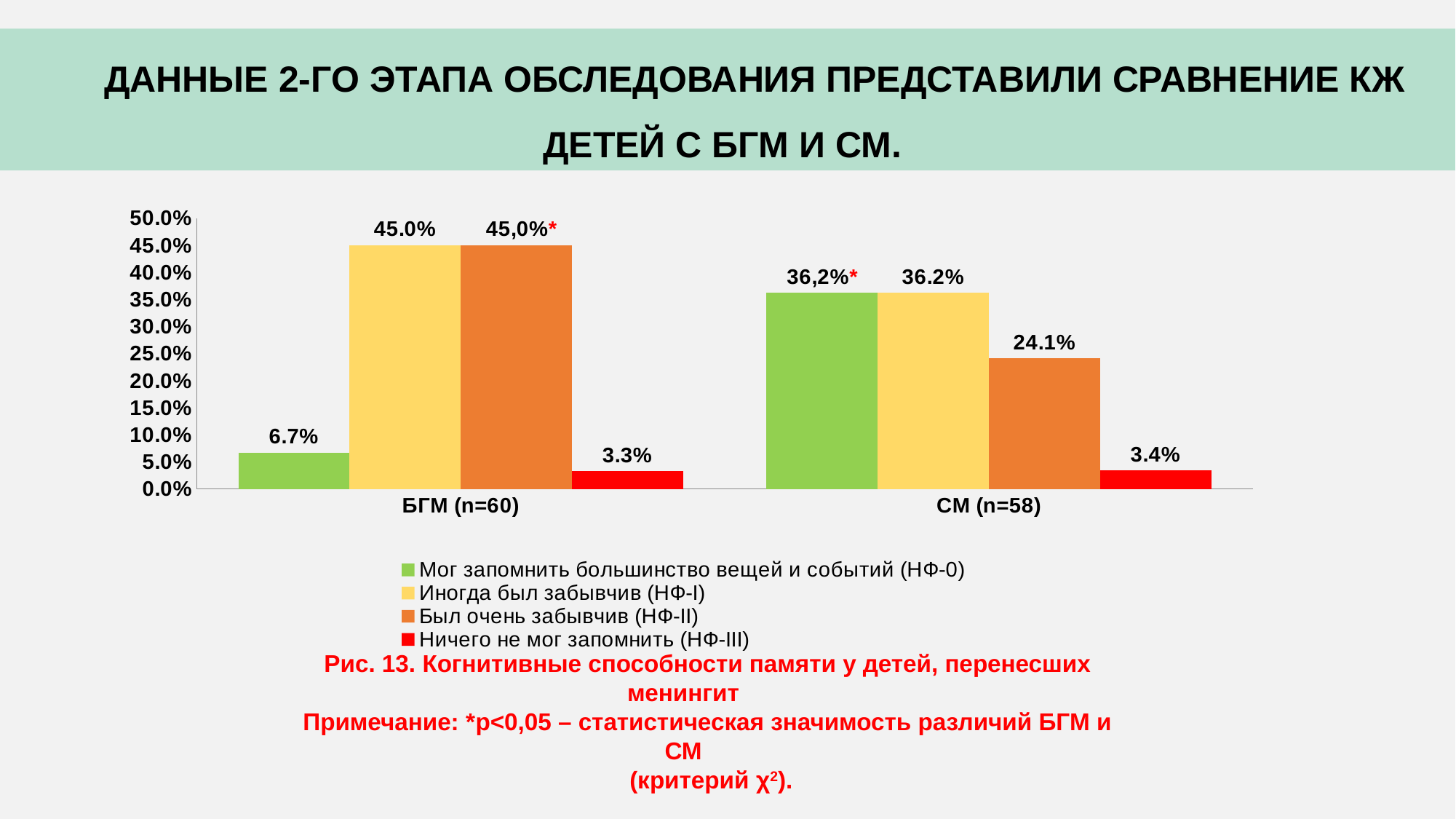
Which group has the larger value for 'Мог запомнить большинство вещей и событий (НФ-0)': БГМ (n=60) or СМ (n=58)? СМ (n=58) What is the value for 'Был очень забывчив (НФ-II)' in the СМ (n=58) group? 24.1% What kind of chart is shown on the slide? bar chart What colour represents 'Ничего не мог запомнить (НФ-III)' in the legend? red What is the value for 'Мог запомнить большинство вещей и событий (НФ-0)' in the БГМ (n=60) group? 6.7% What is the value for 'Иногда был забывчив (НФ-I)' in the БГМ (n=60) group? 45.0% How many series does the legend list? 4 What is the difference between the 'Был очень забывчив (НФ-II)' values for БГМ (n=60) and СМ (n=58)? 20.9% What is the value for 'Ничего не мог запомнить (НФ-III)' in the СМ (n=58) group? 3.4% How many categories are shown on the x axis? 2 Which series has the lowest value in the СМ (n=58) group? Ничего не мог запомнить (НФ-III) Which series has the lowest value in the БГМ (n=60) group? Ничего не мог запомнить (НФ-III)